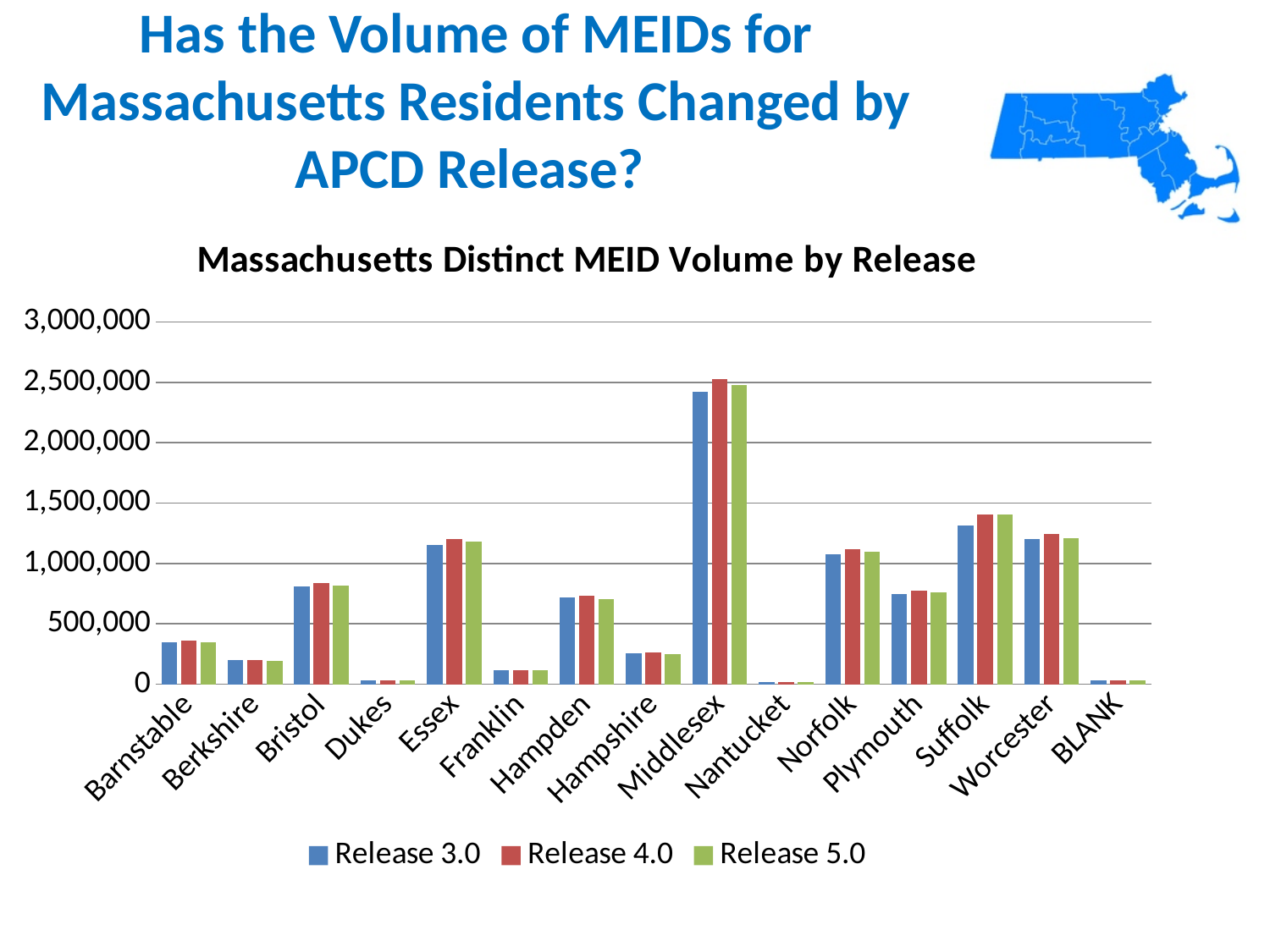
Is the Release 3.0 value for Essex greater or less than 1,000,000? greater Is the Release 5.0 value for Hampshire greater or less than 500,000? less What kind of chart is shown on the slide? bar chart How many categories are shown on the x axis? 15 How many series does the legend list? 3 For Release 3.0, which is larger, Suffolk or Worcester? Suffolk For Release 4.0, which is larger, Bristol or Hampden? Bristol Is the Release 3.0 value for Bristol greater or less than 500,000? greater Which category has the highest MEID volume? Middlesex What is the title of the chart? Massachusetts Distinct MEID Volume by Release